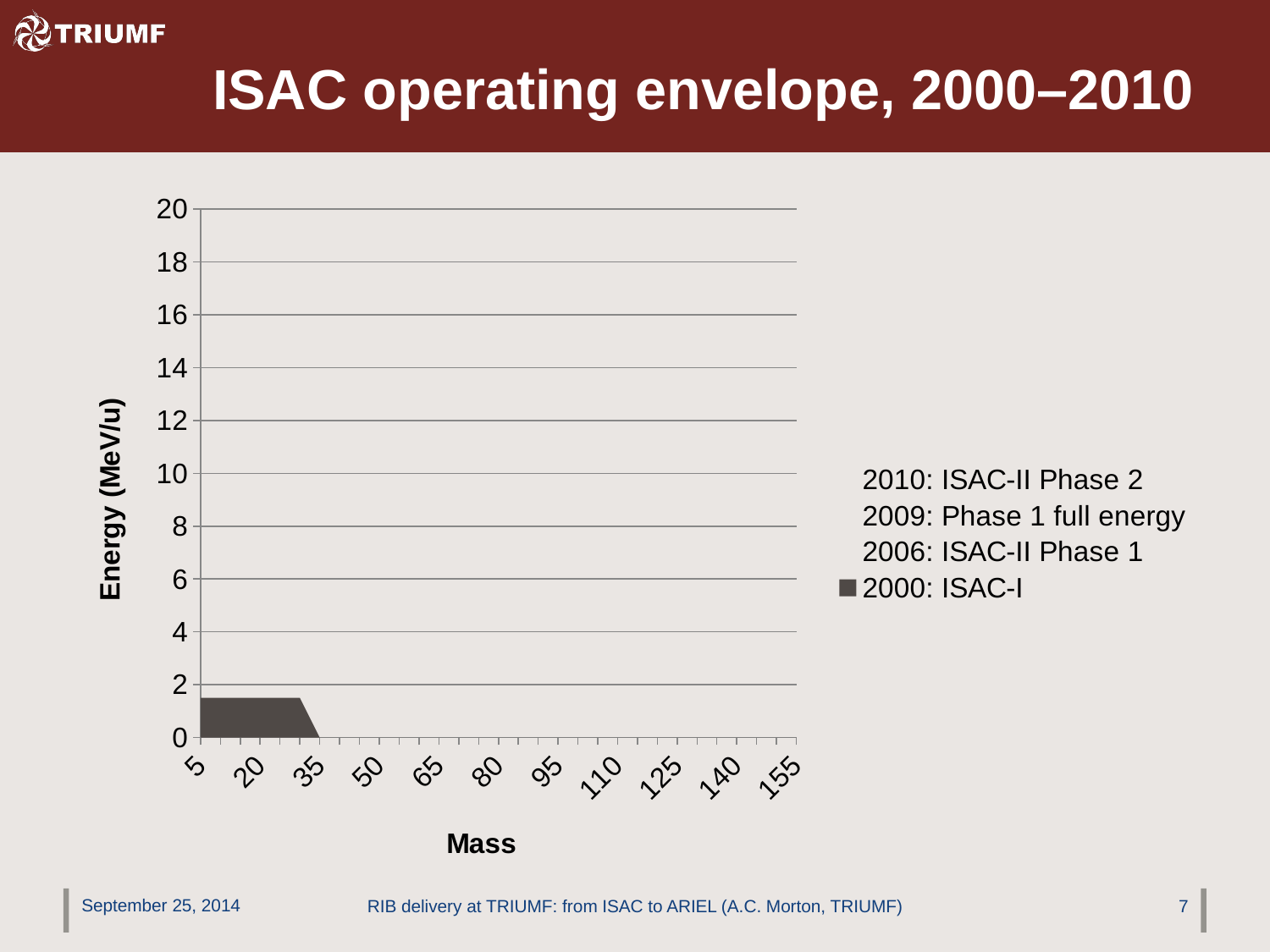
What is the title of the chart? ISAC operating envelope, 2000–2010 Is the energy for the 2000: ISAC-I series at mass 20 greater or less than 4? less What is the label of the vertical axis? Energy (MeV/u) Is the energy for the 2000: ISAC-I series at mass 5 greater or less than 2? less Which legend entry corresponds to the shaded area visible on the chart? 2000: ISAC-I How many tick labels are shown on the Mass axis? 11 How many series does the legend list? 4 What kind of chart is shown on the slide? area chart What is the highest value shown on the Energy (MeV/u) axis? 20